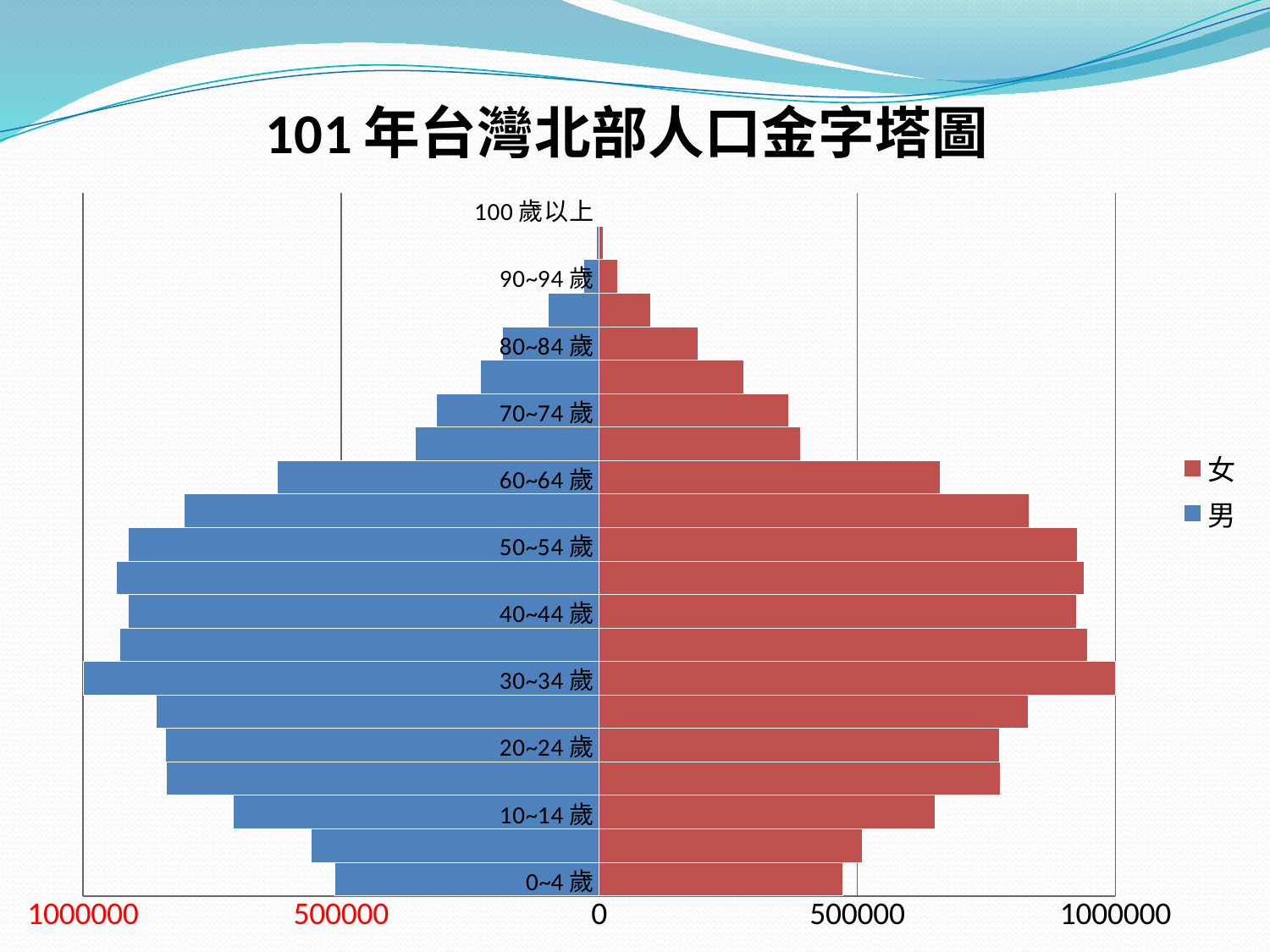
Which age group has the largest 男 (male) population? 30~34 歲 Which age group has the smallest population for both 男 and 女? 100 歲以上 Moving from 30~34 歲 up to 100 歲以上, do the bars get longer or shorter? shorter How many series does the legend list? 2 Is the 女 value for 10~14 歲 greater or less than 500000? greater Which age group has a larger 男 population, 60~64 歲 or 70~74 歲? 60~64 歲 What is the title of the chart? 101 年台灣北部人口金字塔圖 Which age group has the largest 女 (female) population? 30~34 歲 What kind of chart is shown on the slide? bar chart Is the 男 value for 80~84 歲 greater or less than 500000? less Is the 女 value for 0~4 歲 greater or less than 500000? less Which series is shown in red in the legend? 女